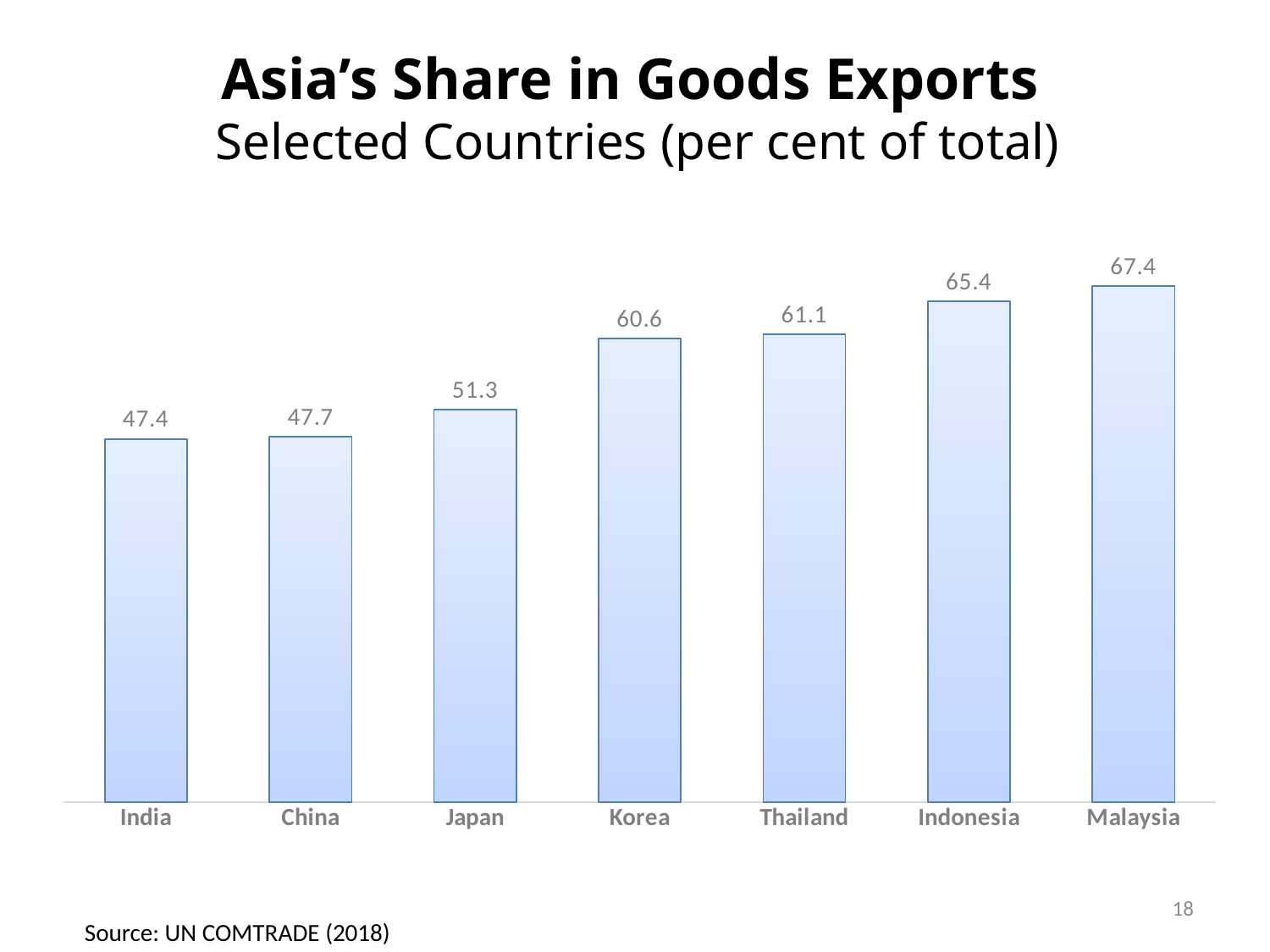
What is the source cited for the chart? UN COMTRADE (2018) What is the value shown for Indonesia? 65.4 What kind of chart is shown on the slide? Bar chart What is Asia's share in goods exports for Japan? 51.3 Which country has the highest share? Malaysia Which is larger, the value for Korea or the value for Indonesia? Indonesia What is the difference between the values for Malaysia and India? 20 What is the value shown for Thailand? 61.1 Do the values rise or fall moving from India to Malaysia along the x axis? Rise What is the difference between the values for Korea and Japan? 9.3 Which country has the lowest share? India How many countries are shown in the chart? 7